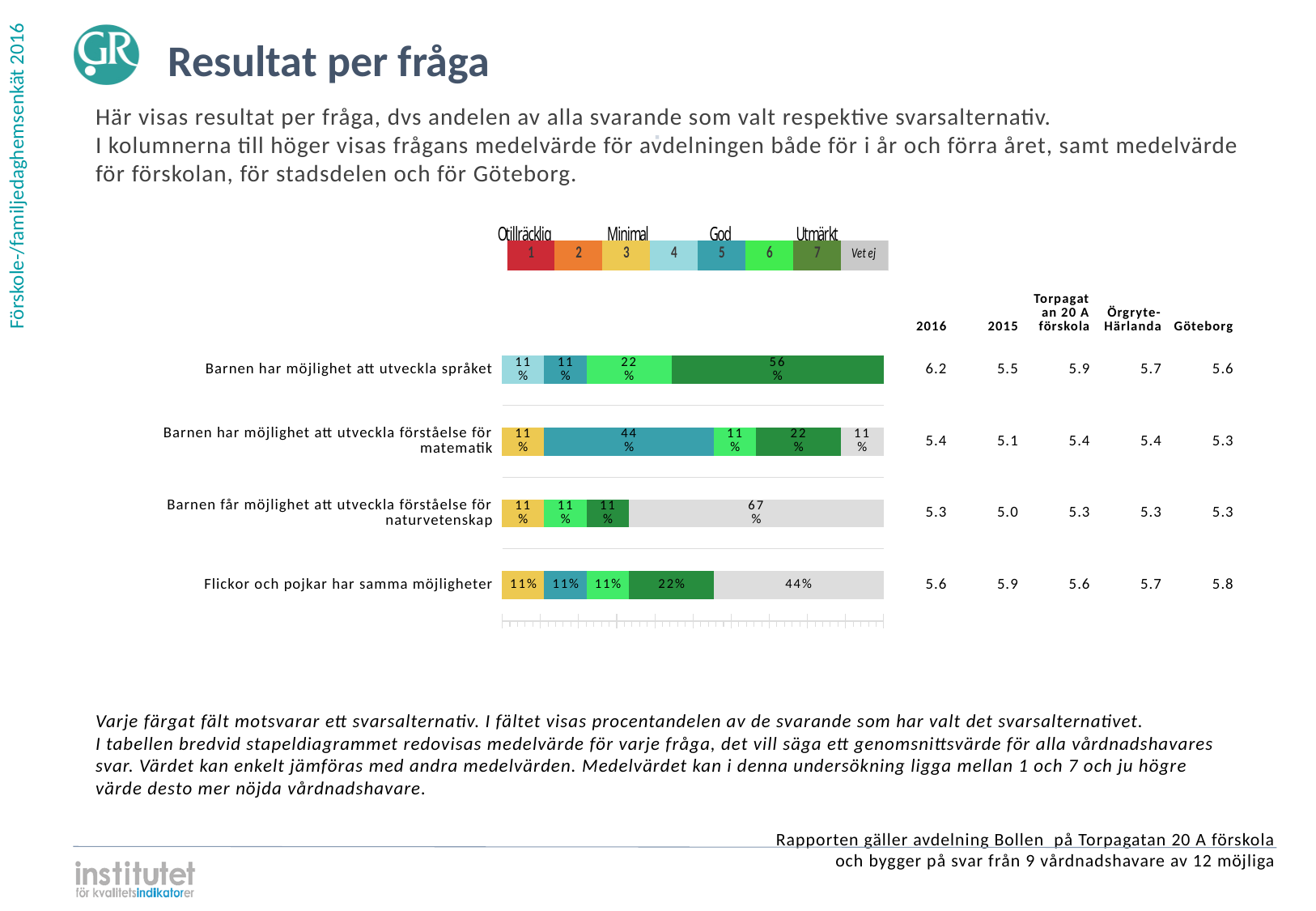
What kind of chart is used to show the results per question? Stacked bar chart What is the 2016 mean value shown for 'Barnen har möjlighet att utveckla språket'? 6.2 Which is larger: the 'Vet ej' share for 'Barnen får möjlighet att utveckla förståelse för naturvetenskap' or for 'Flickor och pojkar har samma möjligheter'? Barnen får möjlighet att utveckla förståelse för naturvetenskap How many response alternatives does the legend above the chart list, including 'Vet ej'? 8 What is the difference between the 'Utmärkt' share for 'Barnen har möjlighet att utveckla språket' (56%) and for 'Flickor och pojkar har samma möjligheter' (22%)? 34% Which question has the highest share of 'Utmärkt' (dark green) responses? Barnen har möjlighet att utveckla språket What is the largest segment in the bar for 'Barnen har möjlighet att utveckla förståelse för matematik'? 44% What percentage of respondents chose 'Utmärkt' (7, dark green) for 'Barnen har möjlighet att utveckla språket'? 56% How many questions (categories) are shown as bars in the chart? 4 What percentage of respondents answered 'Vet ej' for 'Barnen får möjlighet att utveckla förståelse för naturvetenskap'? 67% What percentage of respondents answered 'Vet ej' for 'Flickor och pojkar har samma möjligheter'? 44%